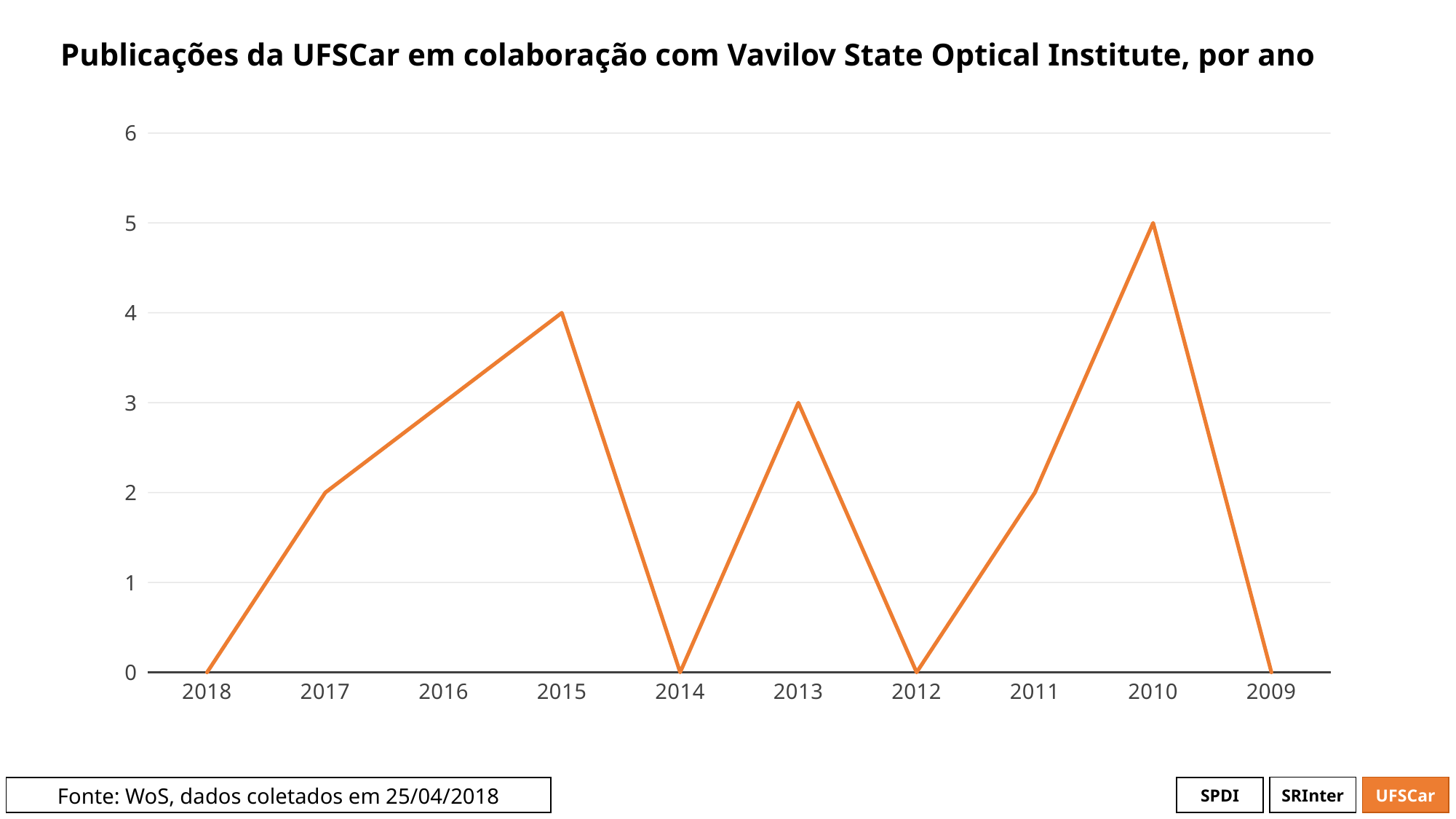
Which is larger, the value for 2013 or the value for 2011? 2013 What is the value for 2015? 4 What is the value for 2017? 2 What kind of chart is shown on the slide? line chart Is the value for 2016 greater or less than 2? greater What is the value for 2010? 5 Which year has the highest number of publications? 2010 How many years are shown on the x axis of the chart? 10 What is the value for 2014? 0 What is the value for 2013? 3 What is the title of the chart? Publicações da UFSCar em colaboração com Vavilov State Optical Institute, por ano What is the difference between the values for 2010 and 2015? 1